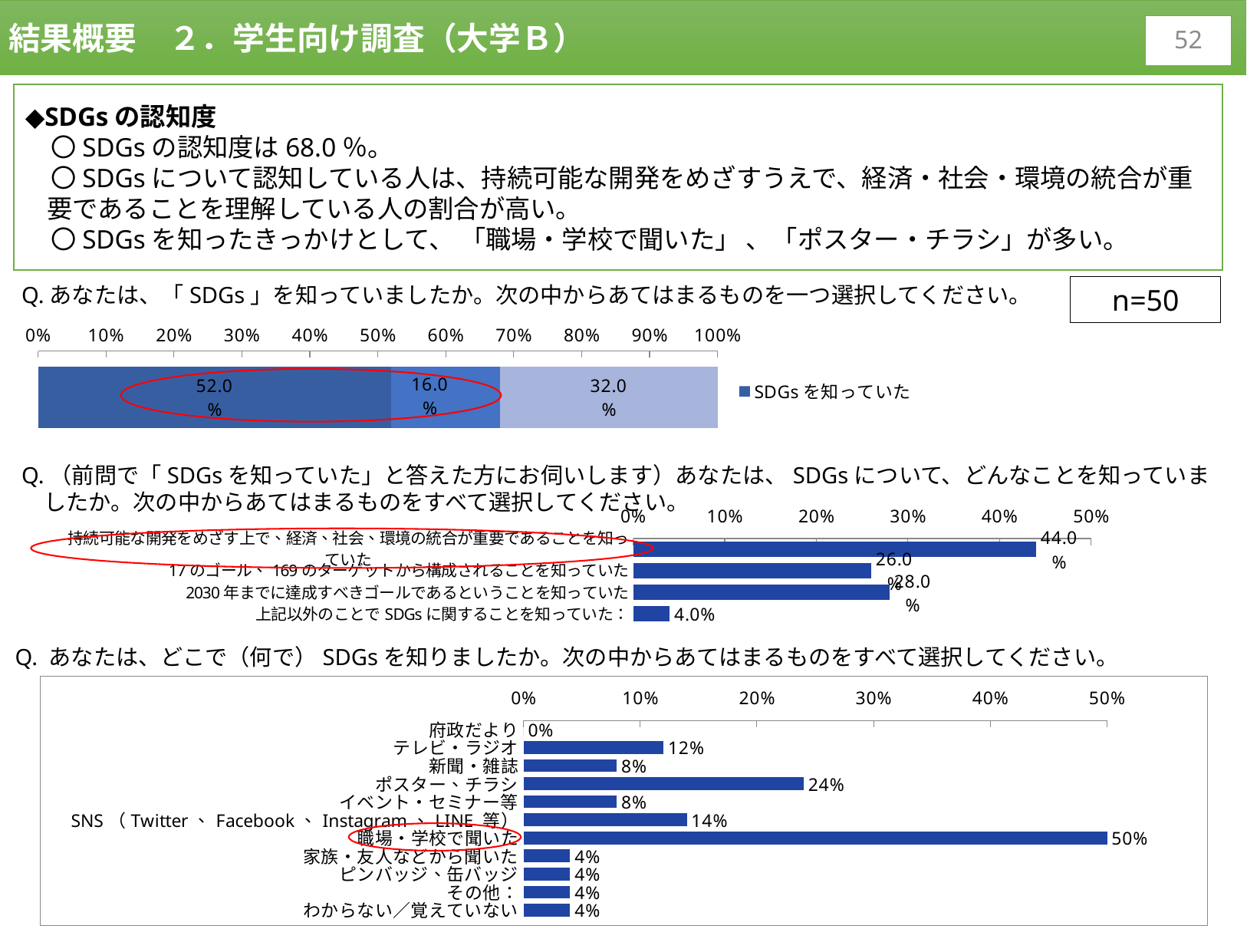
In the bottom chart, what is the value for ポスター、チラシ? 24% In the top stacked bar chart, what is the value of the first (leftmost) segment? 52.0% How many categories are shown in the bottom chart? 11 In the bottom chart, which category has the highest value? 職場・学校で聞いた In the bottom chart (where respondents learned about SDGs), what is the value for 職場・学校で聞いた? 50% In the middle chart, which category has the highest value? 持続可能な開発をめざす上で、経済、社会、環境の統合が重要であることを知っていた In the bottom chart, what is the difference between テレビ・ラジオ and 新聞・雑誌? 4% What kind of chart is the bottom chart? Bar chart In the top stacked bar chart, what is the value of the rightmost segment? 32.0% In the bottom chart, which category has the lowest value? 府政だより In the middle chart (what respondents knew about SDGs), what is the value for 上記以外のことでSDGsに関することを知っていた? 4.0% In the bottom chart, which is larger: SNS（Twitter、Facebook、Instagram、LINE 等） or イベント・セミナー等? SNS（Twitter、Facebook、Instagram、LINE 等）